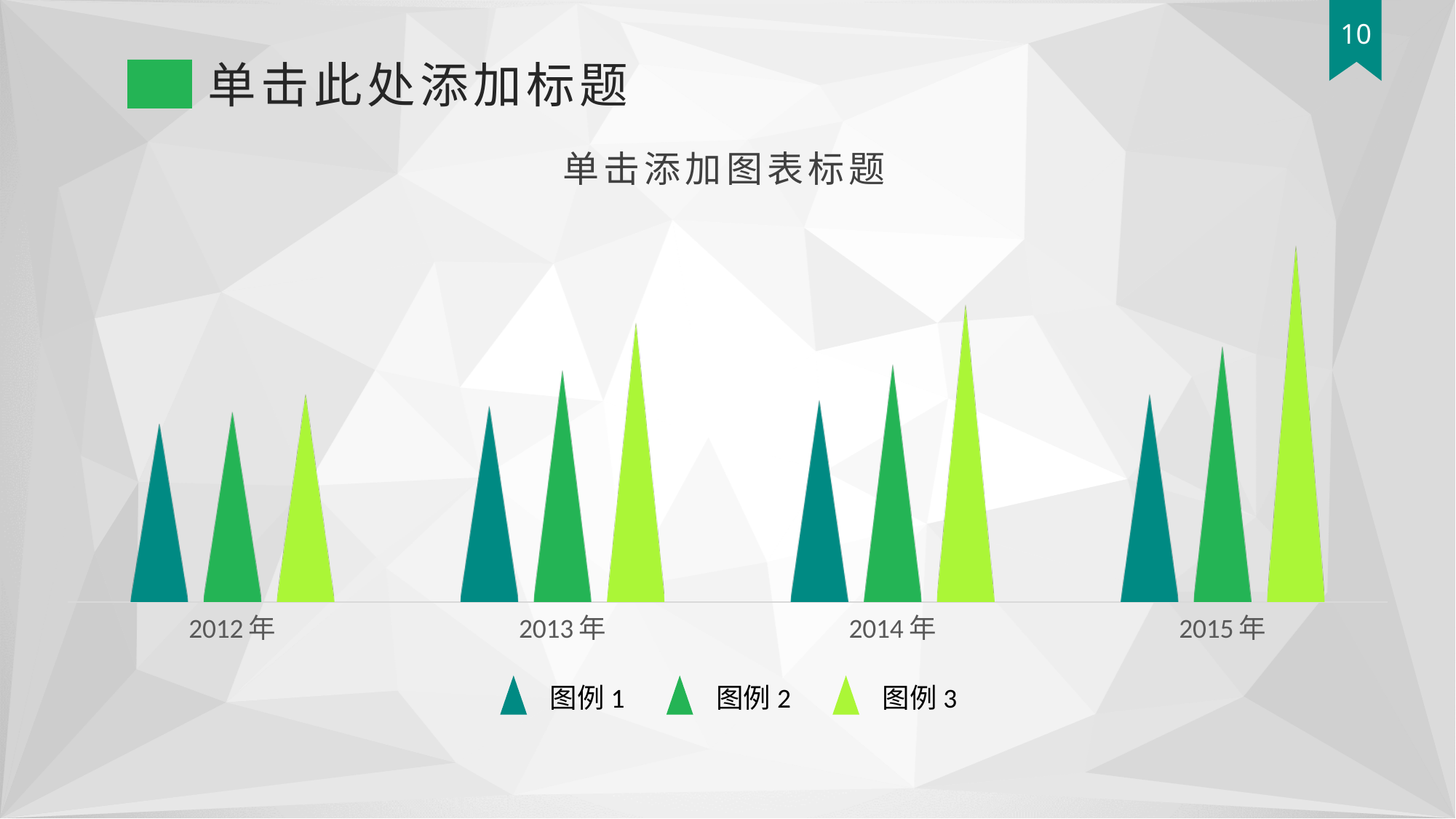
Which category has the lowest value for 图例 1? 2012 年 How many series does the chart legend list? 3 Which category has the lowest value for 图例 3? 2012 年 What are the names of the series listed in the chart legend? 图例 1, 图例 2, 图例 3 In 2014 年, which series has the lowest value? 图例 1 Which category has the highest value for 图例 3? 2015 年 Which is larger: the value for 图例 3 in 2015 年 or in 2012 年? 2015 年 What kind of chart is shown on the slide? bar chart In 2015 年, which series has the highest value? 图例 3 Do the values for 图例 3 rise or fall from 2012 年 to 2015 年? rise How many categories are shown on the x axis of the chart? 4 Which category has the highest value for 图例 2? 2015 年